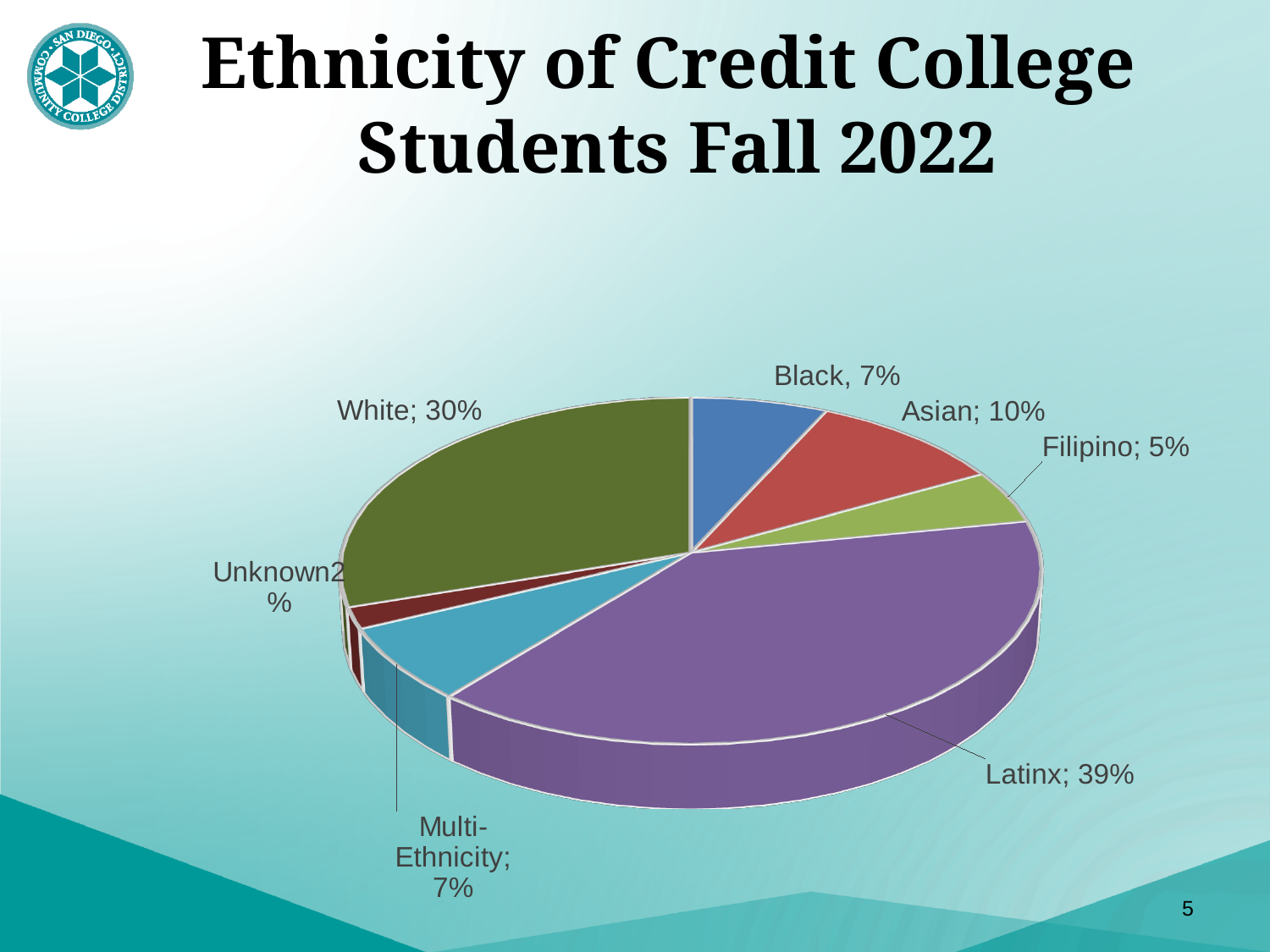
What percentage of credit college students are White? 30% How many ethnicity categories are shown in the pie chart? 7 What percentage of credit college students are Asian? 10% Which share is larger, Asian or Filipino? Asian Which ethnicity has the smallest share of credit college students? Unknown What percentage of credit college students are Filipino? 5% What percentage of credit college students are of Unknown ethnicity? 2% What is the title of the chart on the slide? Ethnicity of Credit College Students Fall 2022 What percentage of credit college students are Latinx? 39% How many percentage points larger is the Latinx share than the White share? 9 Which ethnicity has the largest share of credit college students? Latinx What kind of chart is shown on the slide? Pie chart